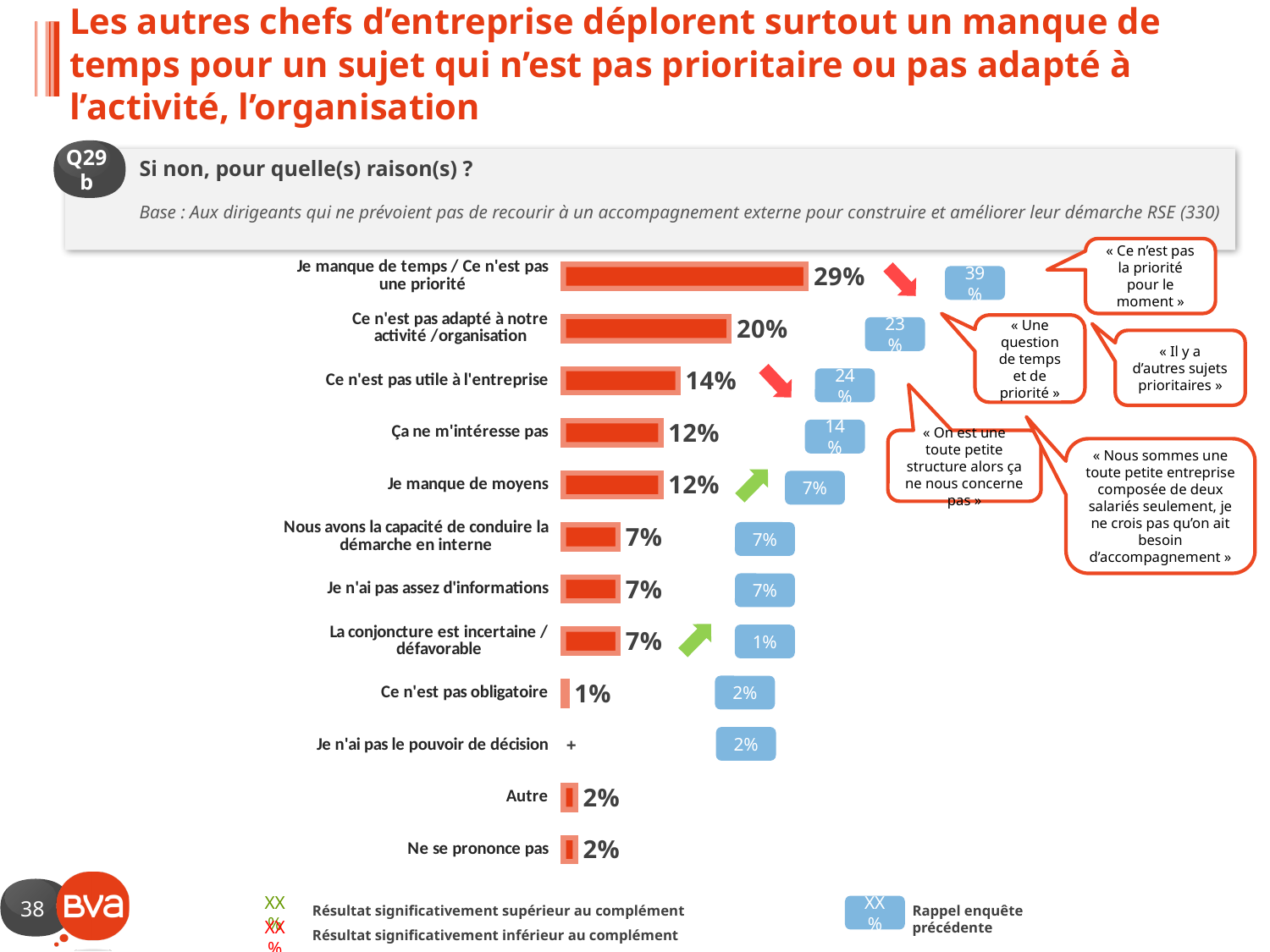
What kind of chart is shown on the slide? Bar chart Which reason has the highest percentage in the chart? Je manque de temps / Ce n'est pas une priorité What is the value shown for "Je manque de moyens"? 12% What was the previous survey value (blue box) for "Je manque de temps / Ce n'est pas une priorité"? 39% What is the value shown for "Ce n'est pas utile à l'entreprise"? 14% What is the value shown for "Ce n'est pas obligatoire"? 1% What is the value shown for "Ce n'est pas adapté à notre activité /organisation"? 20% How many reason categories are listed in the chart? 12 What was the previous survey value (blue box) for "La conjoncture est incertaine / défavorable"? 1% What percentage of respondents cite "Je manque de temps / Ce n'est pas une priorité" as a reason? 29% Which is larger: the value for "Ça ne m'intéresse pas" or the value for "Nous avons la capacité de conduire la démarche en interne"? Ça ne m'intéresse pas What is the difference between the values for "Je manque de temps / Ce n'est pas une priorité" and "Ce n'est pas adapté à notre activité /organisation"? 9 percentage points